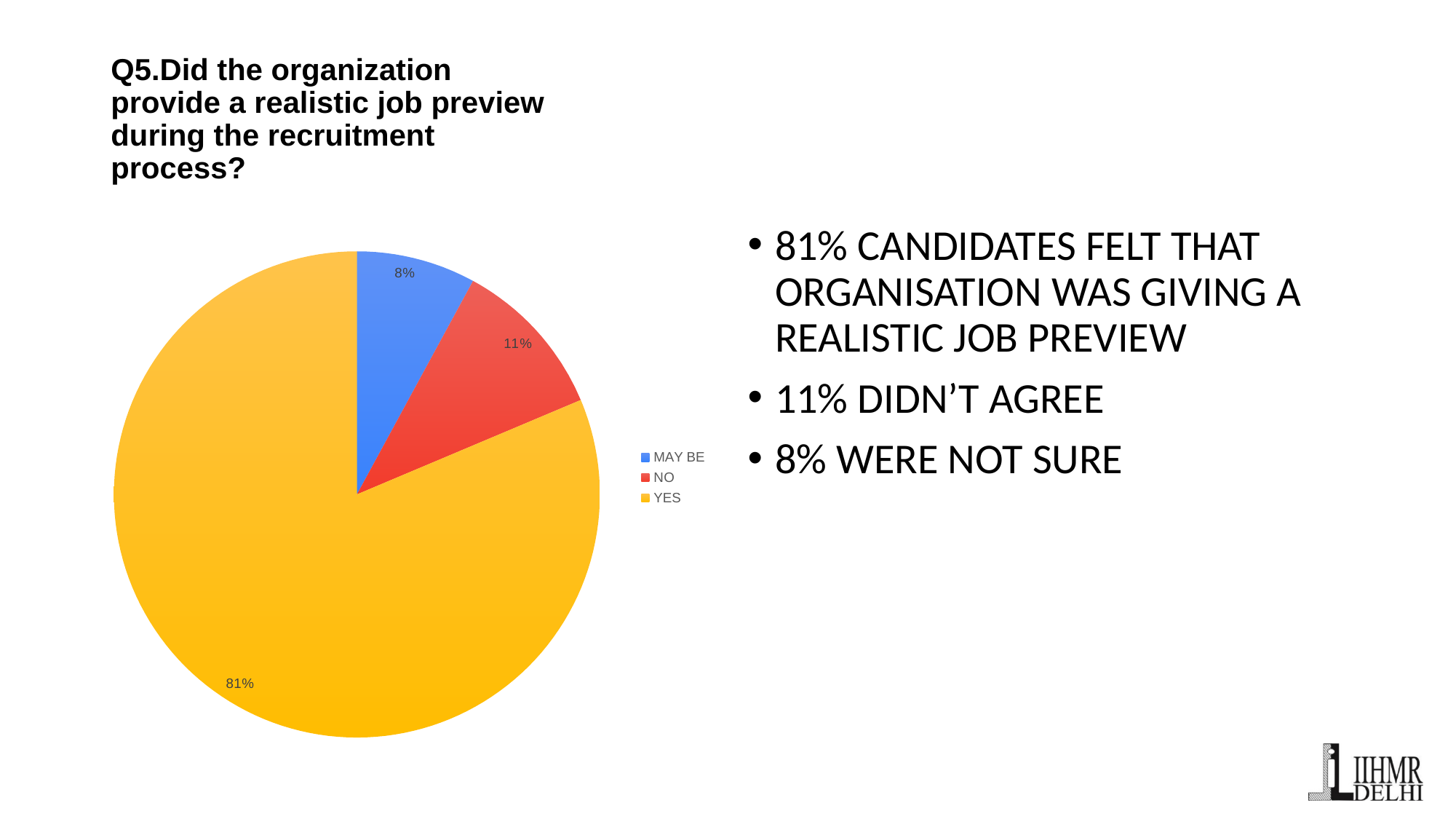
What share of the pie does the YES slice represent? 81% What share of the pie does the MAY BE slice represent? 8% Which category is shown in red in the legend? NO What is the difference in percentage points between the NO and MAY BE slices? 3 Which slice is larger, NO or MAY BE? NO Which category has the largest slice of the pie? YES What colour is the YES slice in the pie chart? yellow What share of the pie does the NO slice represent? 11% What is the difference in percentage points between the YES and NO slices? 70 Which category has the smallest slice of the pie? MAY BE What kind of chart is shown on the slide? pie chart How many categories does the pie chart show? 3